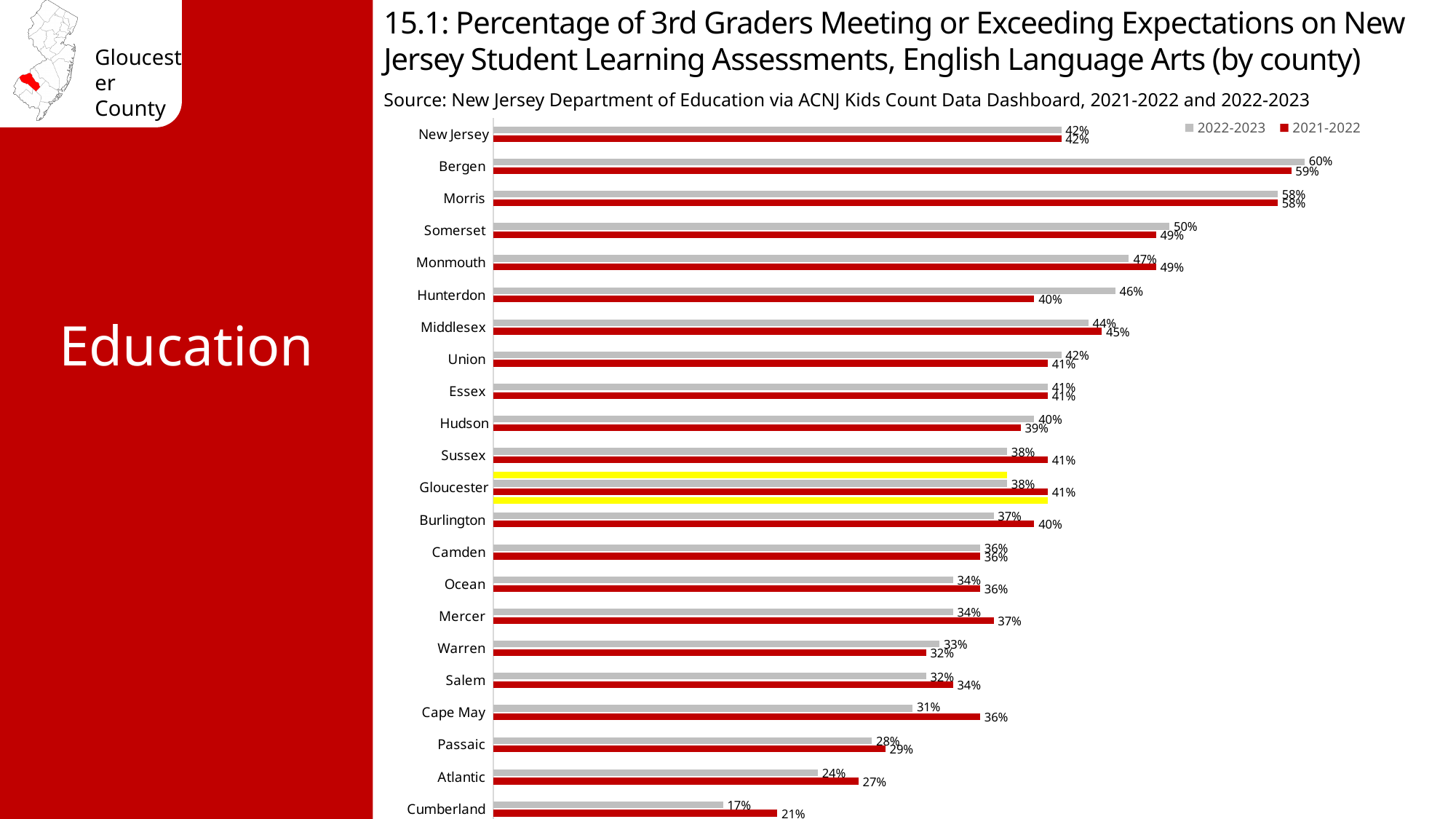
What kind of chart is shown on the slide? Bar chart What is the 2022-2023 value for Cape May? 31% Which is larger for Monmouth: the 2022-2023 value or the 2021-2022 value? 2021-2022 What is the difference between the 2022-2023 and 2021-2022 values for Hunterdon? 6% What is the difference between the 2021-2022 and 2022-2023 values for Cape May? 5% How many series does the legend list? 2 Which county has the highest 2022-2023 value? Bergen What is the 2022-2023 value for Gloucester? 38% How many categories (counties plus New Jersey) are shown on the chart? 22 Which county's row is highlighted in yellow on the chart? Gloucester Which county has the lowest 2021-2022 value? Cumberland What is the 2021-2022 value for Hunterdon? 40%